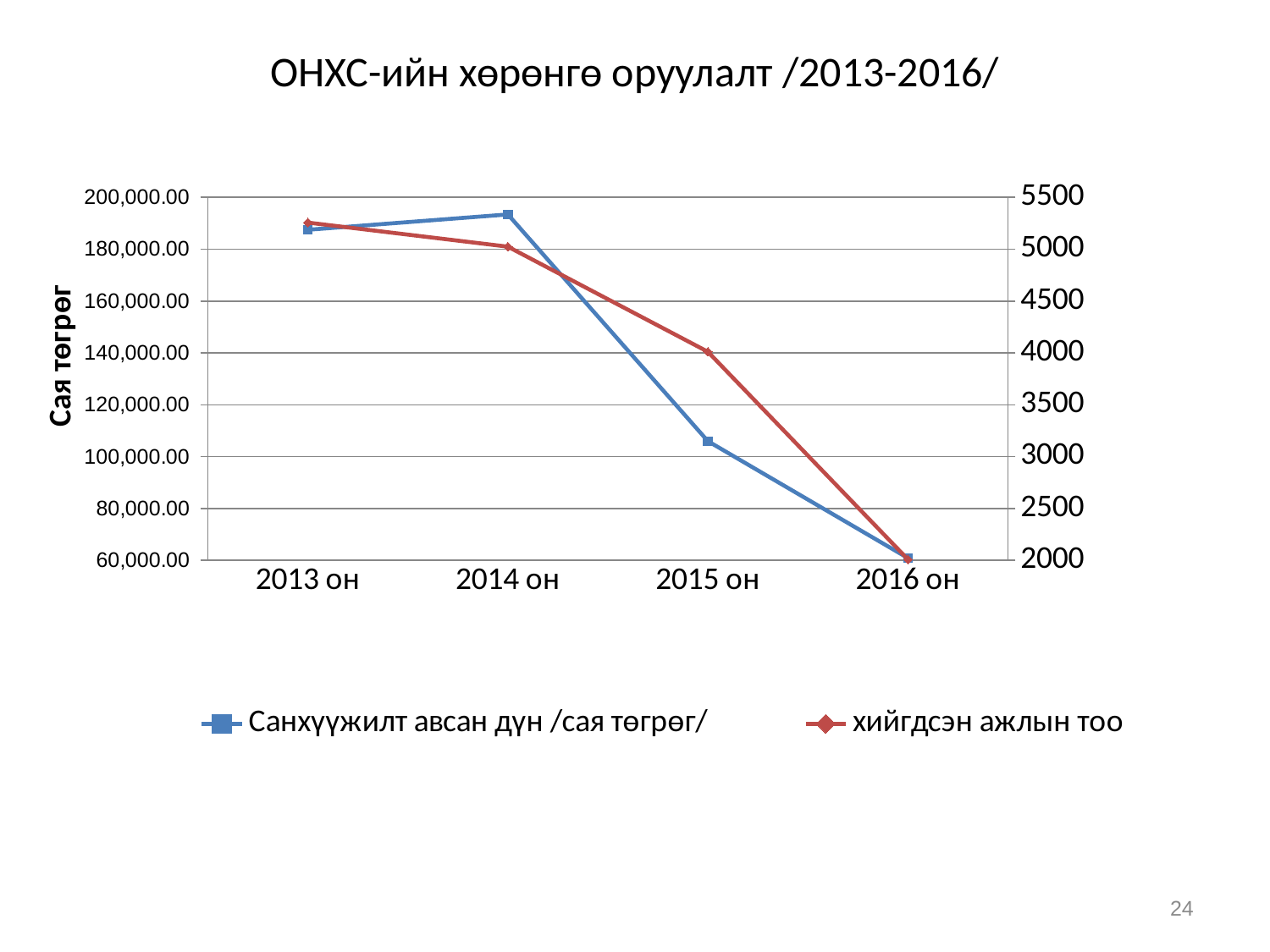
How many years are plotted along the x axis? 4 What kind of chart is shown on the slide? line chart Which is larger for Санхүүжилт авсан дүн /сая төгрөг/: the value in 2013 он or in 2015 он? 2013 он In which year is the value for хийгдсэн ажлын тоо lowest? 2016 он What is the label of the left vertical axis? Сая төгрөг Is the value for хийгдсэн ажлын тоо in 2014 он greater or less than 4500? greater What is the title of the chart? ОНХС-ийн хөрөнгө оруулалт /2013-2016/ In which year is the value for хийгдсэн ажлын тоо highest? 2013 он Is the value for Санхүүжилт авсан дүн /сая төгрөг/ in 2015 он greater or less than 120,000.00? less From 2014 он to 2016 он, does the value for хийгдсэн ажлын тоо rise or fall? fall How many series does the legend list? 2 In which year is the value for Санхүүжилт авсан дүн /сая төгрөг/ lowest? 2016 он